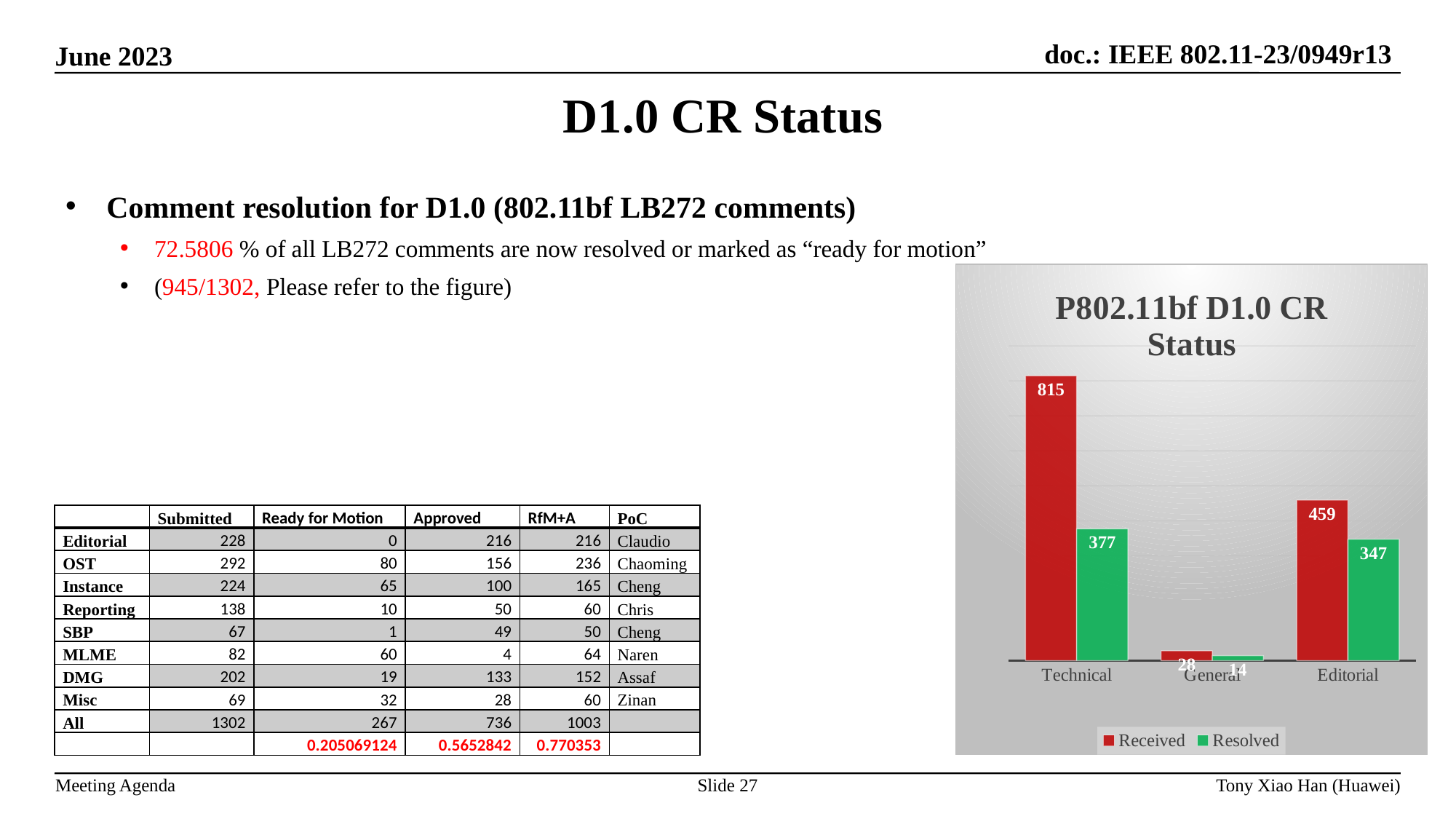
How many series does the legend list? 2 What is the Received value for General? 28 What is the difference between Received and Resolved for Editorial? 112 What is the Resolved value for Technical? 377 What is the Resolved value for Editorial? 347 What is the Received value for Technical? 815 What is the difference between Received and Resolved for Technical? 438 Which category has the highest Received value? Technical What type of chart is shown? Bar chart Which category has the lowest Resolved value? General Which is larger, the Resolved value for Technical or the Resolved value for Editorial? Technical How many categories are shown on the x axis? 3